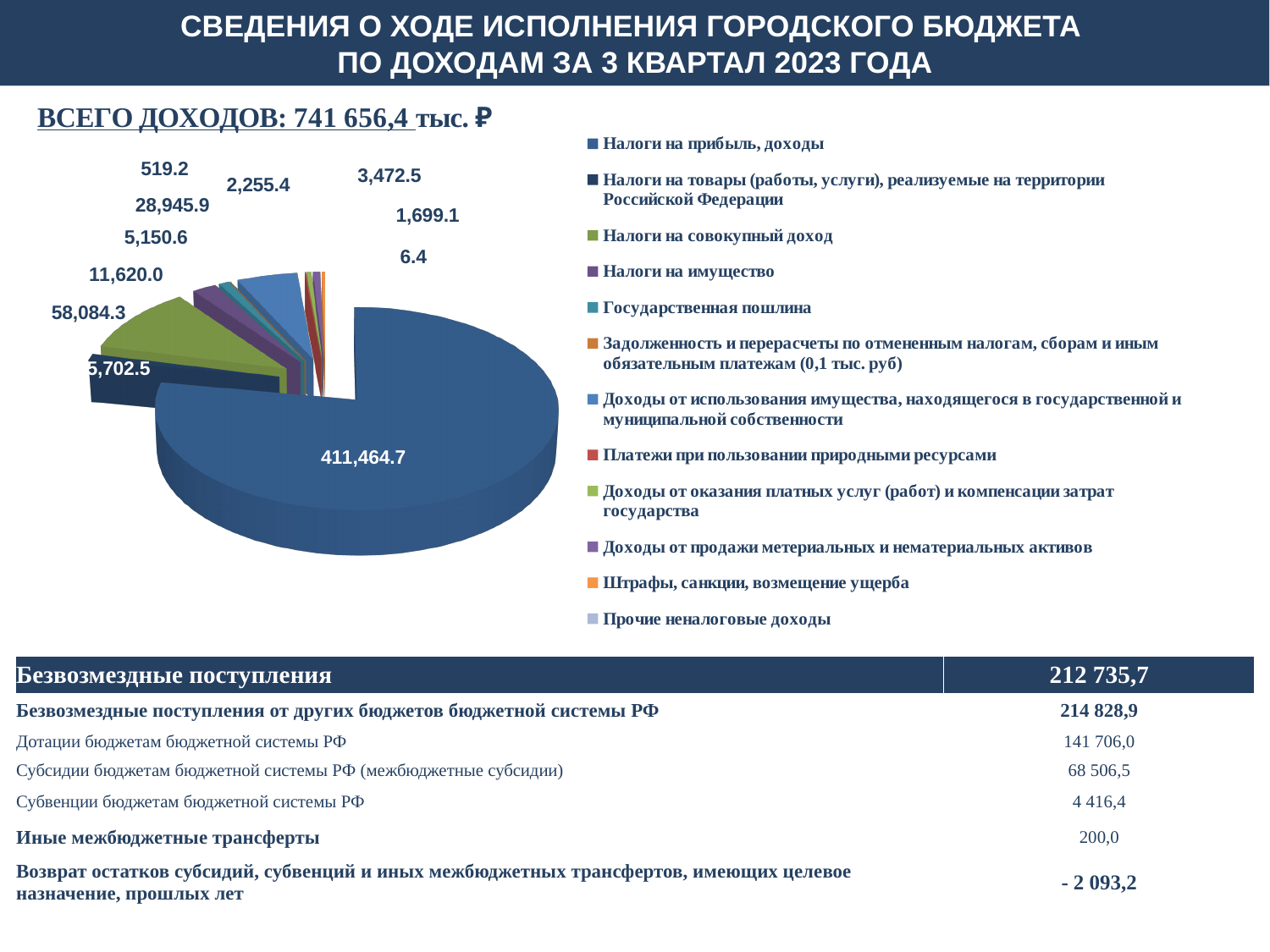
Which category has the largest slice in the pie chart? Налоги на прибыль, доходы What is the difference between the slice labelled 58,084.3 and the slice labelled 28,945.9? 29,138.4 Which is larger, the slice labelled 58,084.3 or the slice labelled 28,945.9? 58,084.3 What is the smallest data label shown on the pie chart? 6.4 What is the second largest value labelled on the pie chart? 58,084.3 What is the difference between the slice labelled 411,464.7 and the slice labelled 58,084.3? 353,380.4 What is the first entry listed in the chart legend? Налоги на прибыль, доходы What is the value of the largest slice in the pie chart? 411,464.7 Is the largest slice of the pie chart greater or less than 400,000? greater What total income (ВСЕГО ДОХОДОВ) is stated above the pie chart? 741 656,4 тыс. ₽ What kind of chart is shown on the slide? pie chart How many entries does the chart legend list? 12